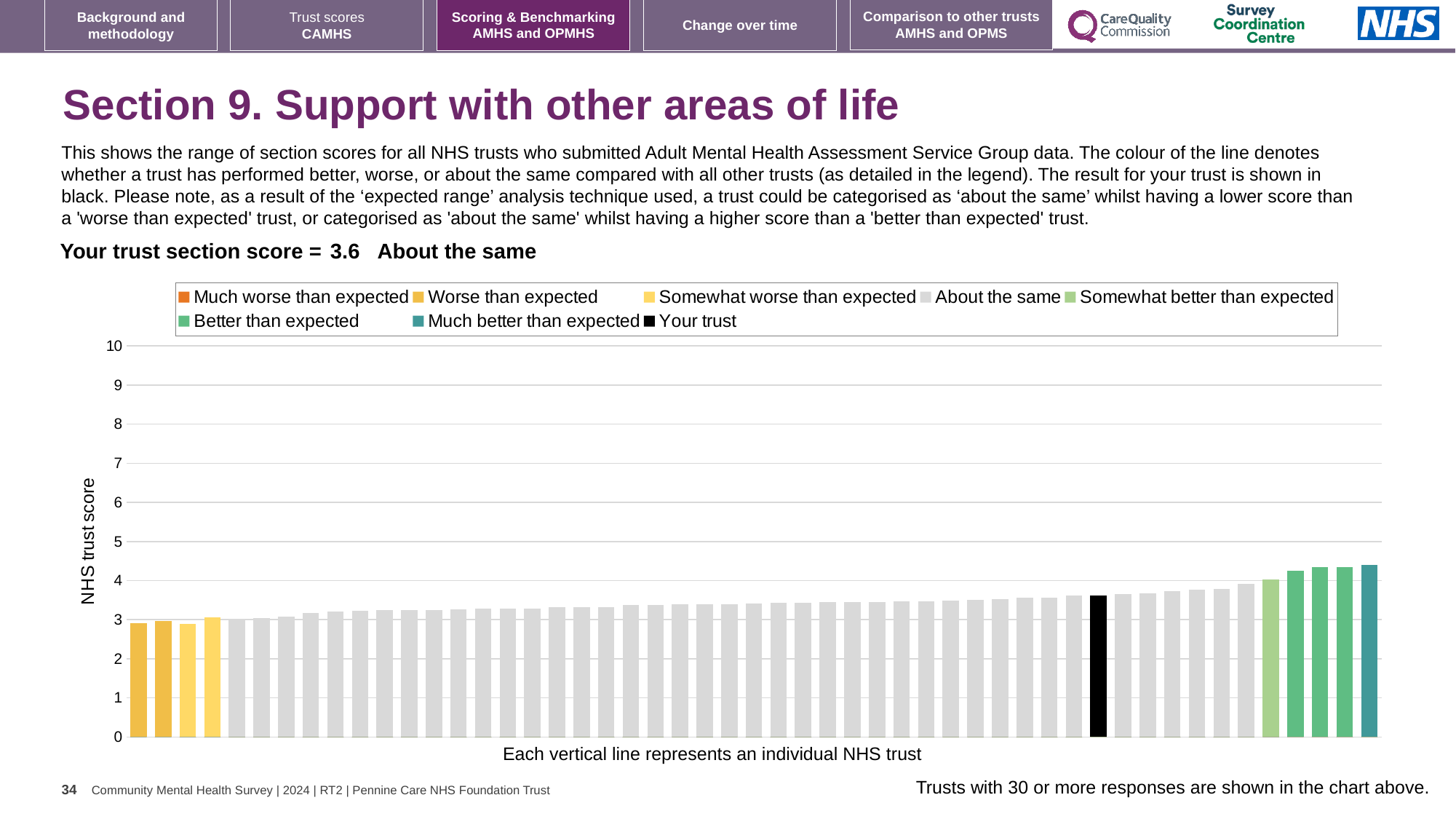
Is the value of the tallest bar greater or less than 5? less What is the label on the vertical axis of the chart? NHS trust score Is the value for your trust greater or less than 4? less What colour is used for 'Your trust' in the legend? black Do the bar values rise or fall from left to right along the x axis? rise Is the value for your trust greater or less than 3? greater How many bars are coloured as 'Better than expected'? 3 What is the section score for your trust? 3.6 How many bars are coloured as 'Much better than expected'? 1 How many entries does the chart legend list? 8 What kind of chart is shown on the slide? bar chart